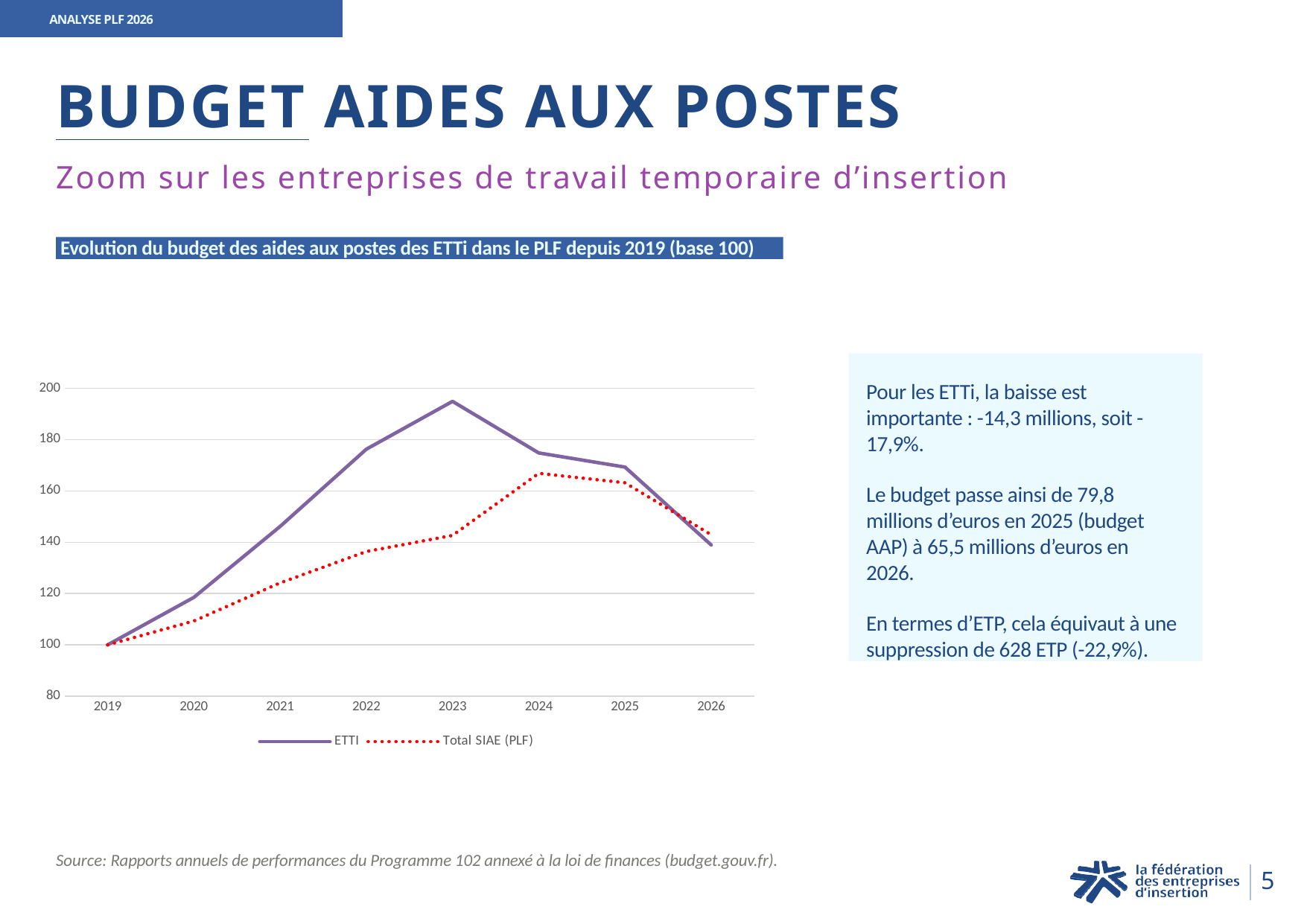
What are the two entries in the chart legend? ETTI and Total SIAE (PLF) Is the value for Total SIAE (PLF) in 2021 greater or less than 140? less Does the ETTI series rise or fall between 2023 and 2026? fall In which year does the ETTI series reach its highest value? 2023 In which year is the ETTI series at its lowest value? 2019 What is the value of the ETTI series in 2019? 100 Is the value for ETTI in 2023 greater or less than 180? greater What kind of chart is shown on the slide? line chart How many years are shown on the x axis of the chart? 8 In 2023, which series has the larger value, ETTI or Total SIAE (PLF)? ETTI How many series does the chart legend list? 2 In which year does the Total SIAE (PLF) series reach its highest value? 2024